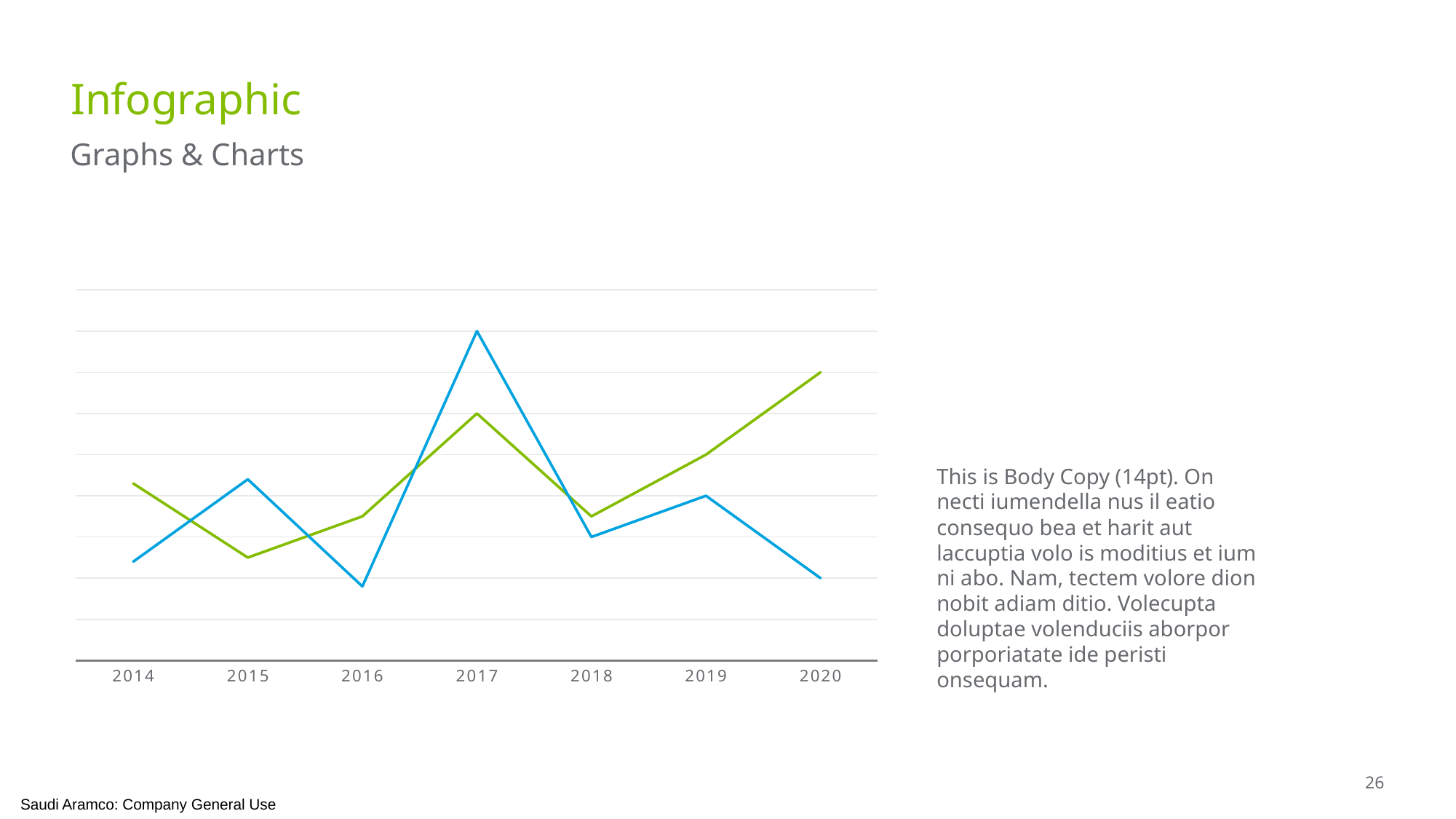
Does the blue line rise or fall from 2019 to 2020? fall What kind of chart is shown on the slide? line chart What is the first year shown on the x axis of the chart? 2014 In which year does the blue line reach its highest point? 2017 How many lines (series) are plotted on the chart? 2 In which year does the blue line reach its lowest point? 2016 In which year does the green line reach its highest point? 2020 In which year does the green line reach its lowest point? 2015 Does the green line rise or fall from 2018 to 2020? rise In 2017, which line is higher, the blue line or the green line? the blue line How many years are shown on the x axis of the chart? 7 In 2020, which line is higher, the blue line or the green line? the green line